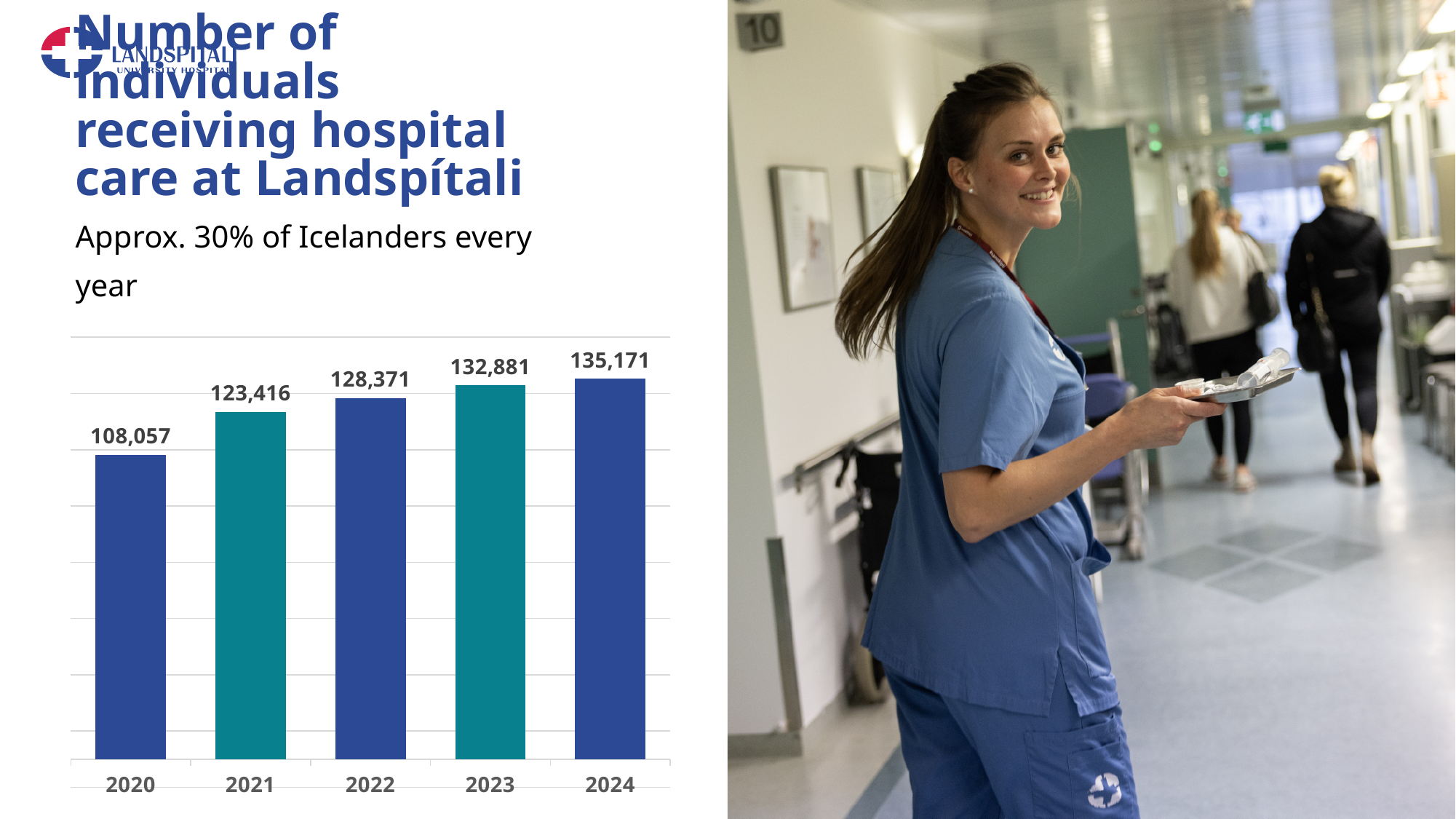
What is the value for 2020? 108,057 Which year has the lowest value? 2020 Which year has the highest value? 2024 What kind of chart is shown? Bar chart Do the values rise or fall from 2020 to 2024? Rise What is the difference between the values for 2021 and 2020? 15,359 What is the difference between the values for 2024 and 2020? 27,114 What colour is the bar for 2021? Teal What is the value for 2022? 128,371 How many years are shown on the x axis? 5 Which is larger, the value for 2023 or the value for 2021? 2023 What is the value for 2024? 135,171